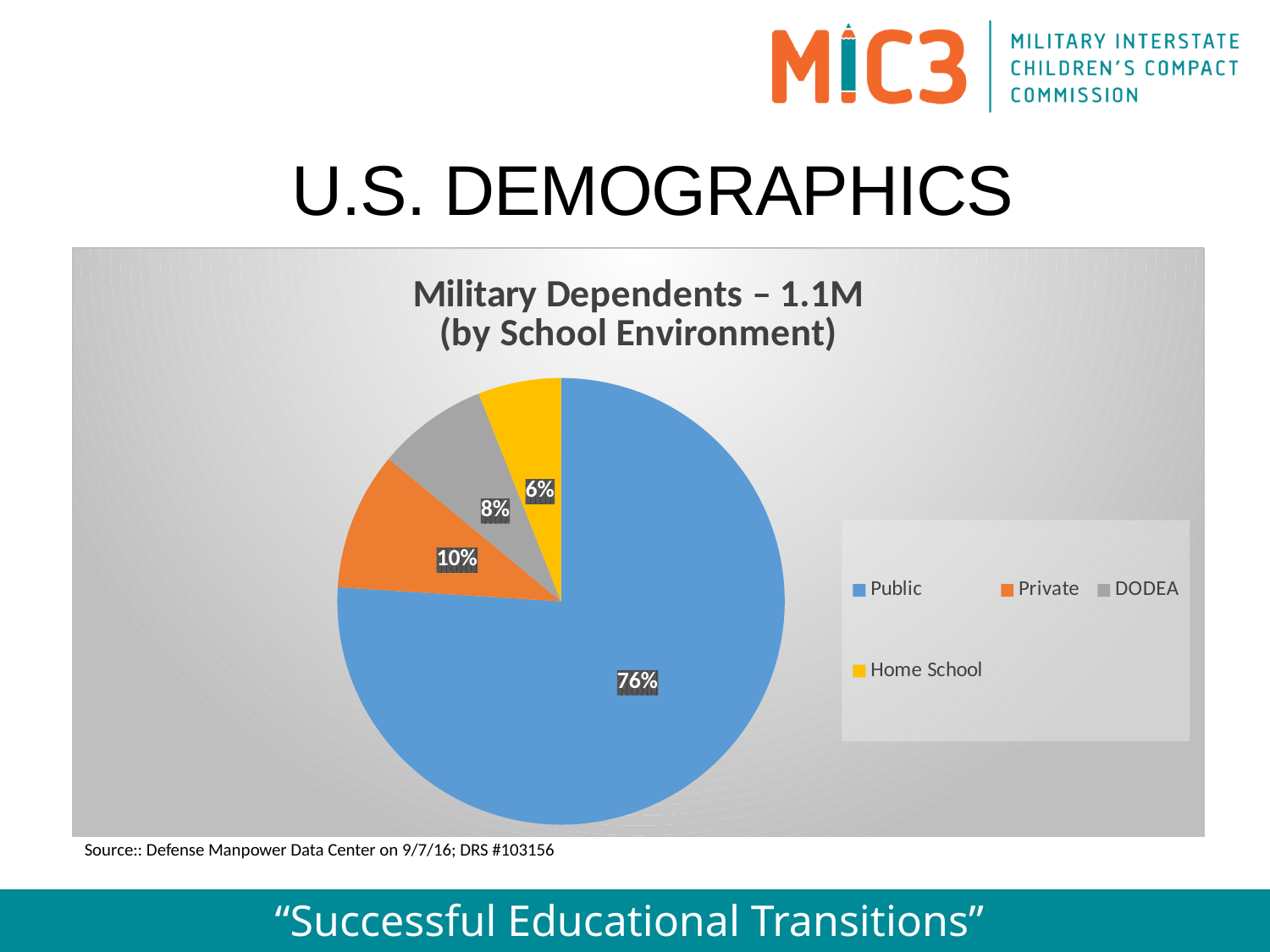
Which school environment has the largest share of military dependents? Public Which school environment has the smallest share of military dependents? Home School What type of chart is shown on the slide? Pie chart Which is larger, the Private share or the DODEA share? Private What share of military dependents attend Public school? 76% What share of military dependents are Home School? 6% What is the title of the chart? Military Dependents – 1.1M (by School Environment) What colour is the Home School slice in the pie chart? Yellow What share of military dependents attend DODEA schools? 8% What is the difference in percentage points between the Public and Private shares? 66 What share of military dependents attend Private school? 10% How many school environment categories does the pie chart show? 4